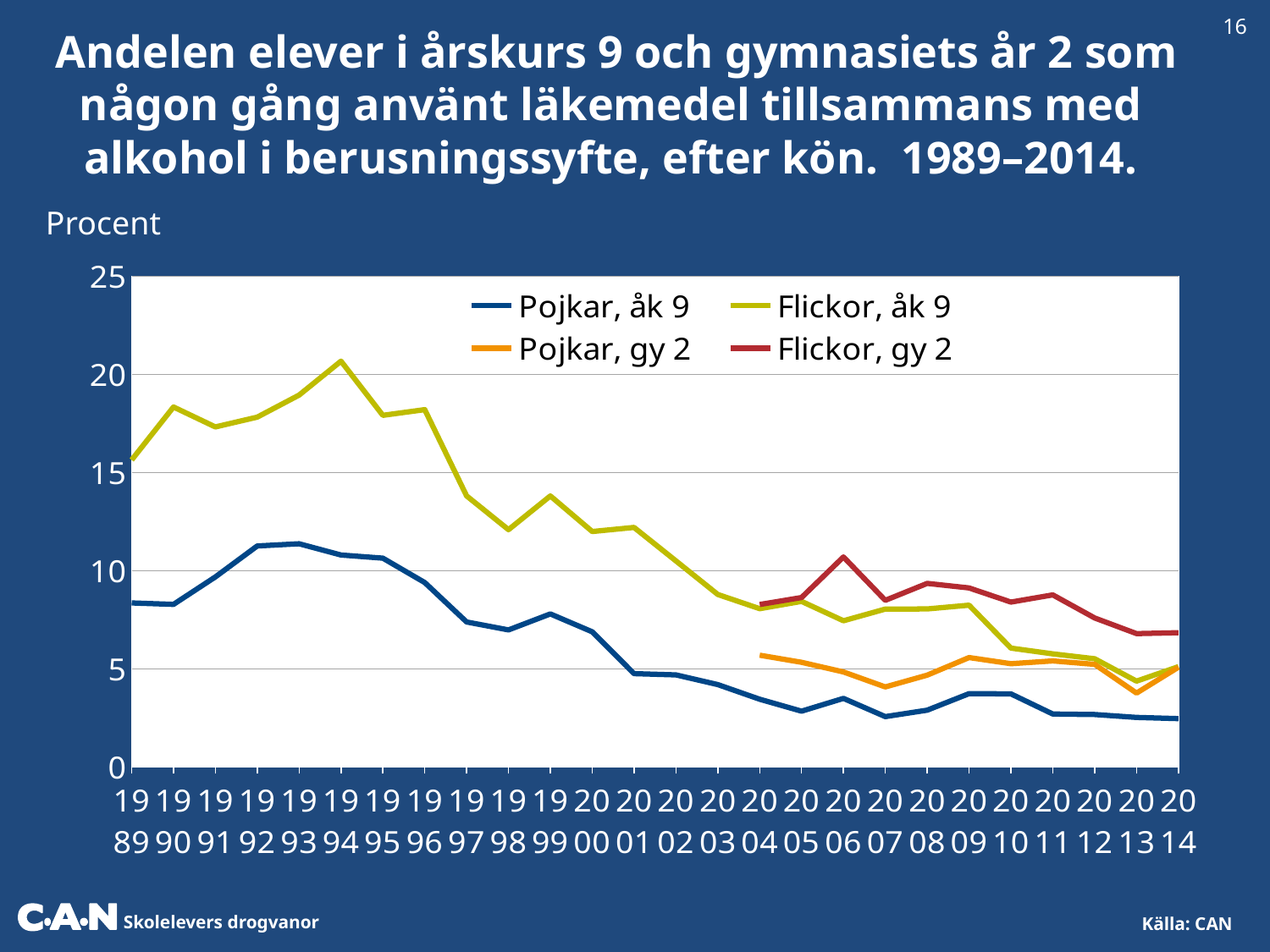
What kind of chart is shown on the slide? line chart Does the Flickor, åk 9 line overall rise or fall from 1989 to 2014? fall In 1994, which is higher: Flickor, åk 9 or Pojkar, åk 9? Flickor, åk 9 How many series does the legend list? 4 Which series reaches the highest value anywhere on the chart? Flickor, åk 9 Which series has the lowest value in 2014? Pojkar, åk 9 Is the value for Flickor, åk 9 in 1990 greater or less than 15? greater Is the value for Pojkar, åk 9 in 1993 greater or less than 10? greater What label is shown above the y axis of the chart? Procent In which year does the Flickor, åk 9 line reach its peak? 1994 Is the value for Pojkar, åk 9 in 2014 greater or less than 5? less How many years are shown along the x axis? 26